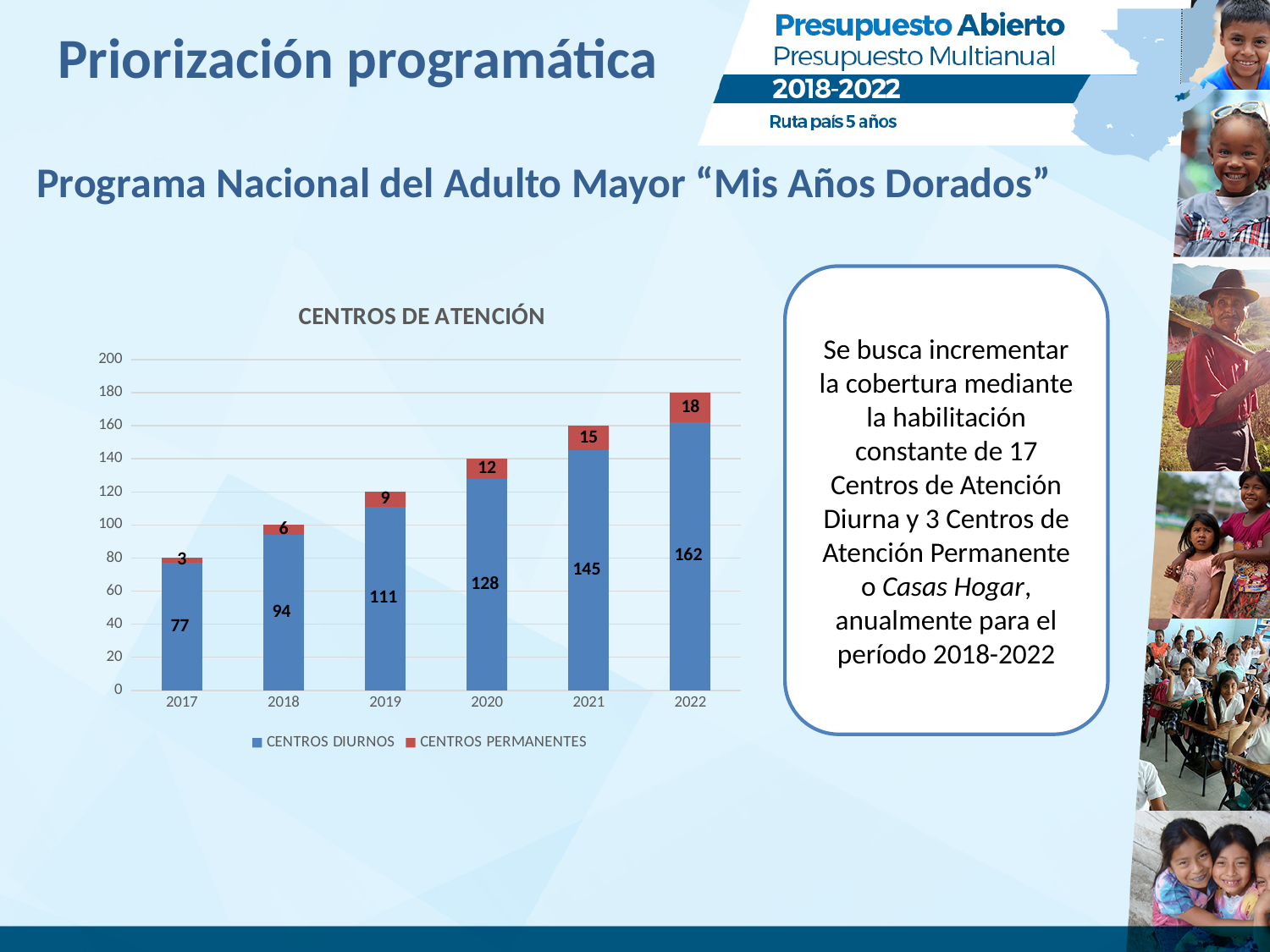
Which is larger: CENTROS PERMANENTES in 2020 or in 2018? 2020 Do the values for CENTROS DIURNOS rise or fall from 2017 to 2022? Rise Which year has the lowest value for CENTROS PERMANENTES? 2017 How many years are shown on the x axis? 6 What is the difference between CENTROS DIURNOS in 2022 and in 2021? 17 What kind of chart is shown? Stacked bar chart What is the total of the stacked bar for 2020? 140 What is the value for CENTROS DIURNOS in 2019? 111 How many series does the legend list? 2 Which year has the highest value for CENTROS DIURNOS? 2022 What is the value for CENTROS PERMANENTES in 2021? 15 What is the value for CENTROS DIURNOS in 2017? 77